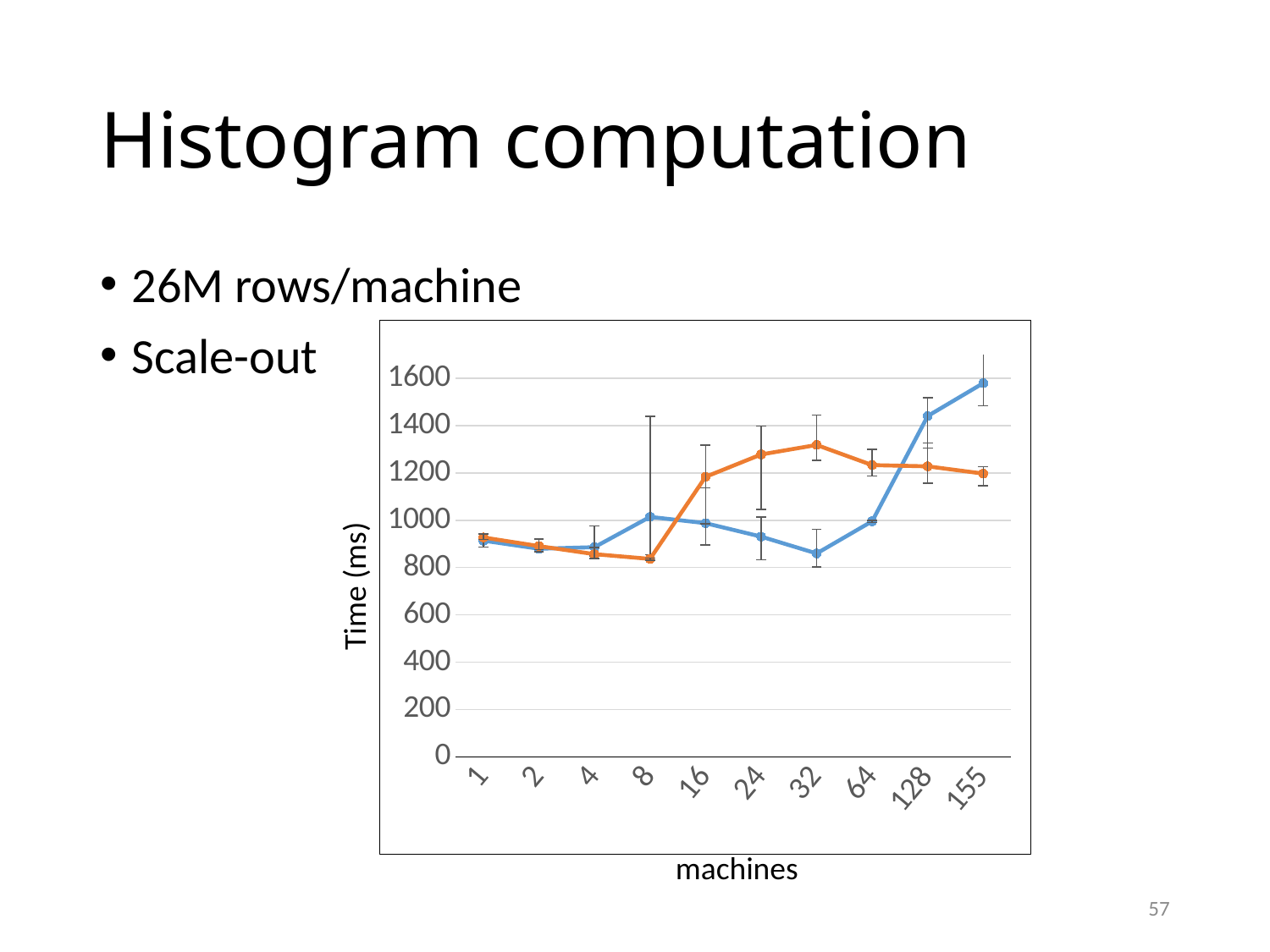
Is the value of the orange line at 8 machines greater or less than 1000? less At which number of machines does the blue line reach its highest value? 155 What is the label of the x axis? machines Is the value of the blue line at 155 machines greater or less than 1400? greater What is the label of the y axis? Time (ms) How many machine counts are plotted along the x axis? 10 At 32 machines, which line has the higher value, blue or orange? orange How many lines (series) are plotted on the chart? 2 Is the value of the orange line at 32 machines greater or less than 1200? greater What kind of chart is shown on the slide? line chart At 155 machines, which line has the higher value, blue or orange? blue